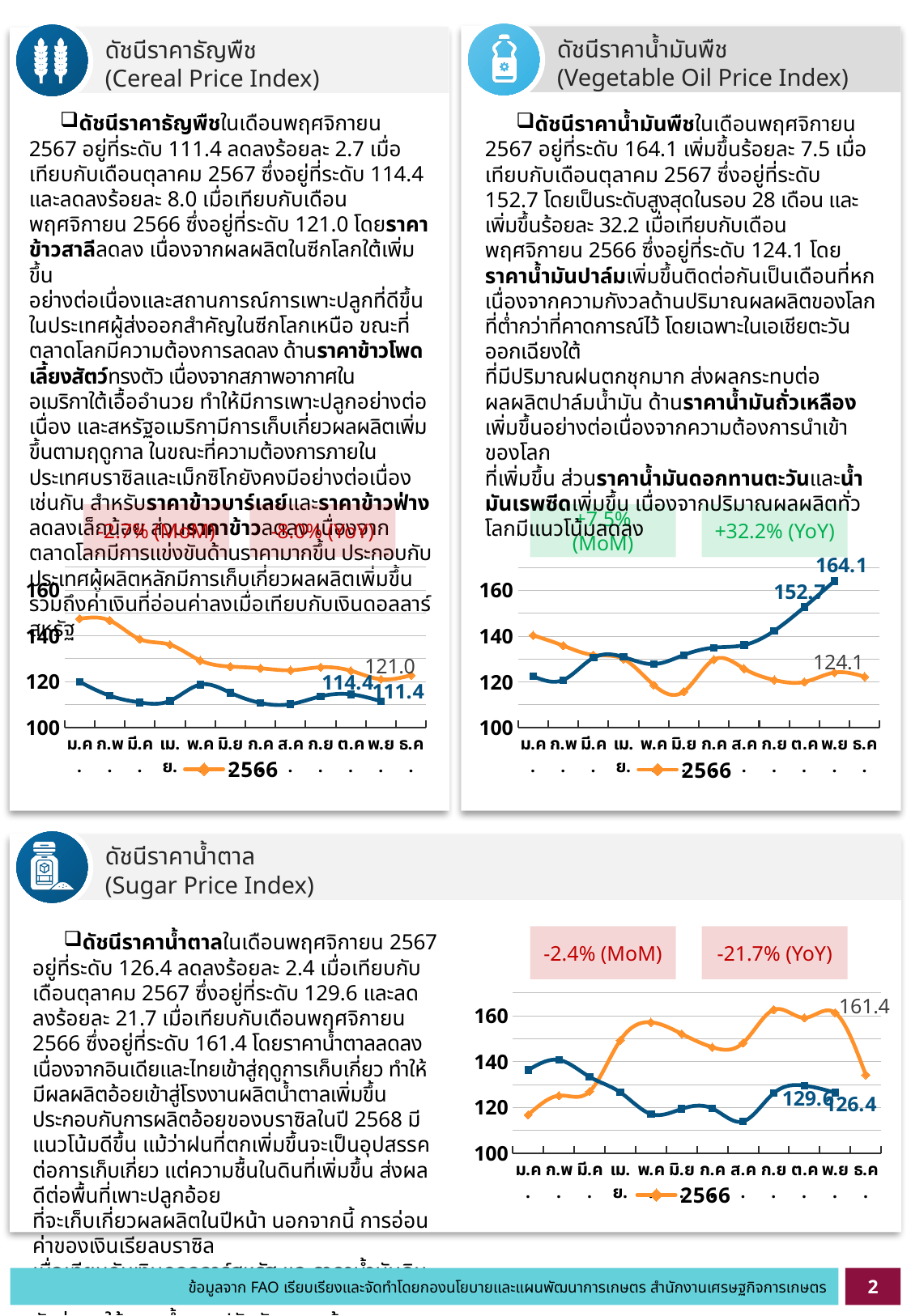
In the Cereal Price Index chart, what is the difference between the 2566 line value at พ.ย. (121.0) and the blue line value at พ.ย. (111.4)? 9.6 In the Vegetable Oil Price Index chart, what is the difference between the blue line values at พ.ย. (164.1) and ต.ค. (152.7)? 11.4 In the Sugar Price Index chart, what is the value of the 2566 (orange) line at พ.ย.? 161.4 In the Vegetable Oil Price Index chart, what is the value of the blue line at ต.ค.? 152.7 In the Vegetable Oil Price Index chart, what is the value of the blue line at พ.ย.? 164.1 What kind of chart is the Cereal Price Index chart? line chart In the Vegetable Oil Price Index chart, is the value of the blue line at ม.ค. greater or less than 140? less In the Sugar Price Index chart, which line has the higher value at พ.ย., the 2566 (orange) line or the blue line? 2566 (orange) line In the Cereal Price Index chart, what is the value of the blue line at พ.ย.? 111.4 In the Cereal Price Index chart, is the value of the 2566 (orange) line at ม.ค. greater or less than 140? greater How many months are shown on the x axis of the Sugar Price Index chart? 12 In the Cereal Price Index chart, what is the value of the 2566 (orange) line at พ.ย.? 121.0